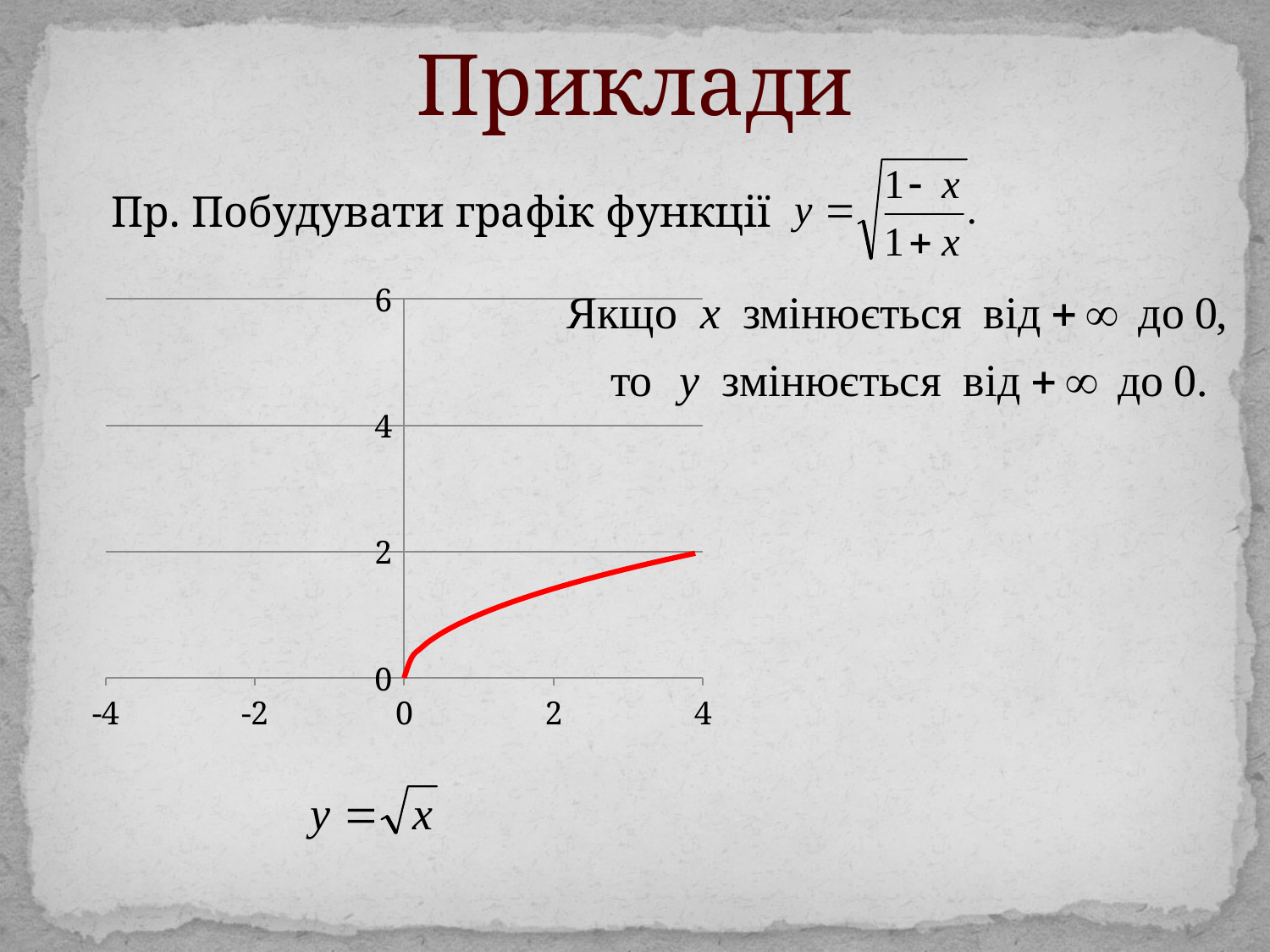
What is the value of y at x = 0 on the plotted curve? 0 What is the highest tick label shown on the vertical axis? 6 Does the plotted curve rise or fall as x increases from 0 to 4? rises Is the value of the curve at x = 1 greater or less than 2? less At which x value does the curve reach its lowest point? 0 Which is larger: the value of the curve at x = 4 or at x = 1? x = 4 Is the value of the curve at x = 2 greater or less than 2? less What colour is the plotted curve? red Is the value of the curve at x = 3 greater or less than 2? less At which x value shown on the axis does the curve reach its highest point? 4 What kind of chart is shown on the slide? line chart